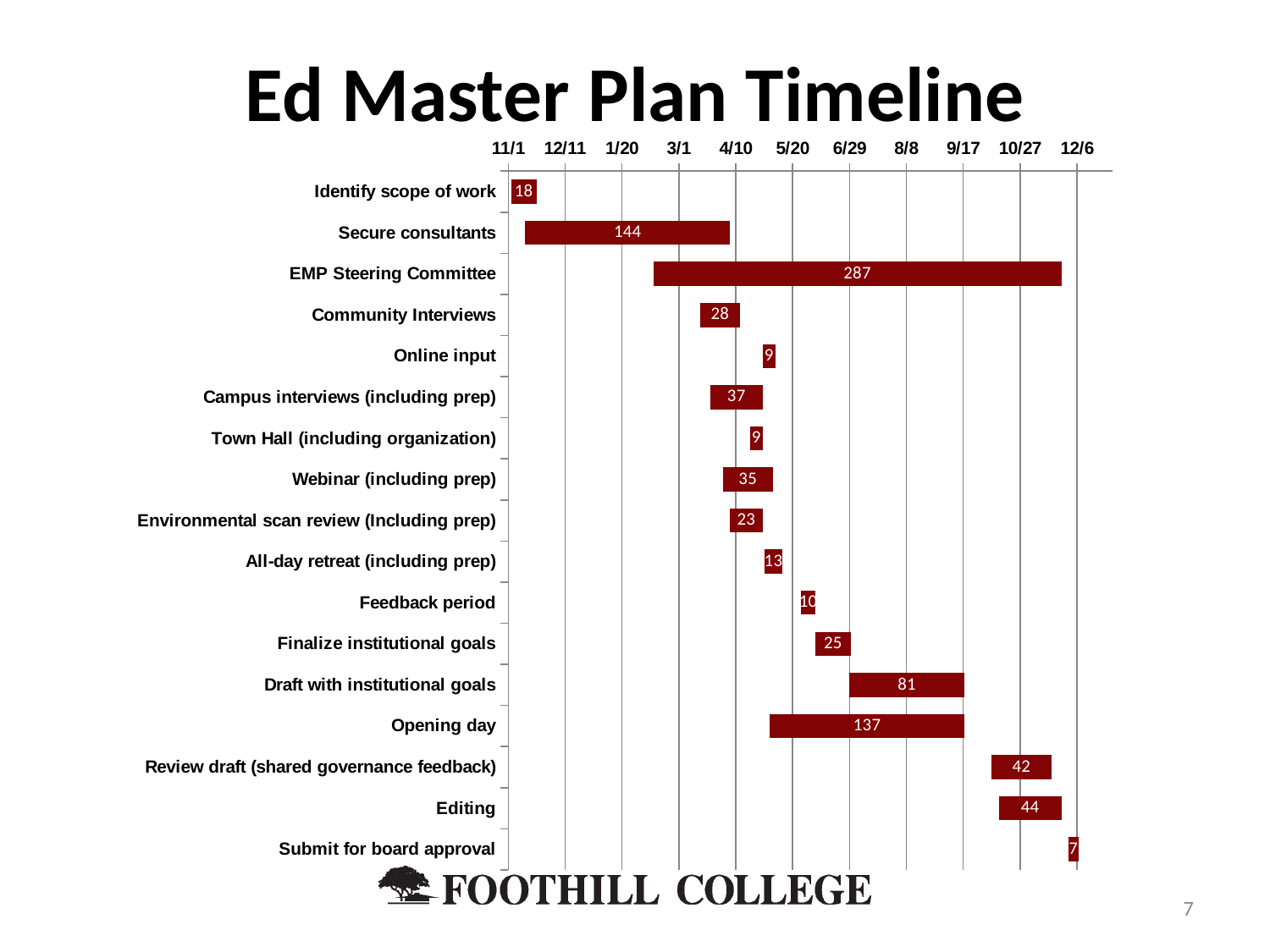
How many categories are shown on the chart? 17 Which category has the lowest value? Submit for board approval What is the difference between the values for Opening day and Draft with institutional goals? 56 Which is larger, the value for Campus interviews (including prep) or the value for Webinar (including prep)? Campus interviews (including prep) What is the title of the slide? Ed Master Plan Timeline What is the difference between the values for Editing and Review draft (shared governance feedback)? 2 What is the value shown for Secure consultants? 144 What is the value shown for Draft with institutional goals? 81 What is the value shown for Review draft (shared governance feedback)? 42 What is the value shown for EMP Steering Committee? 287 What kind of chart is shown on the slide? Bar chart Which category has the highest value? EMP Steering Committee